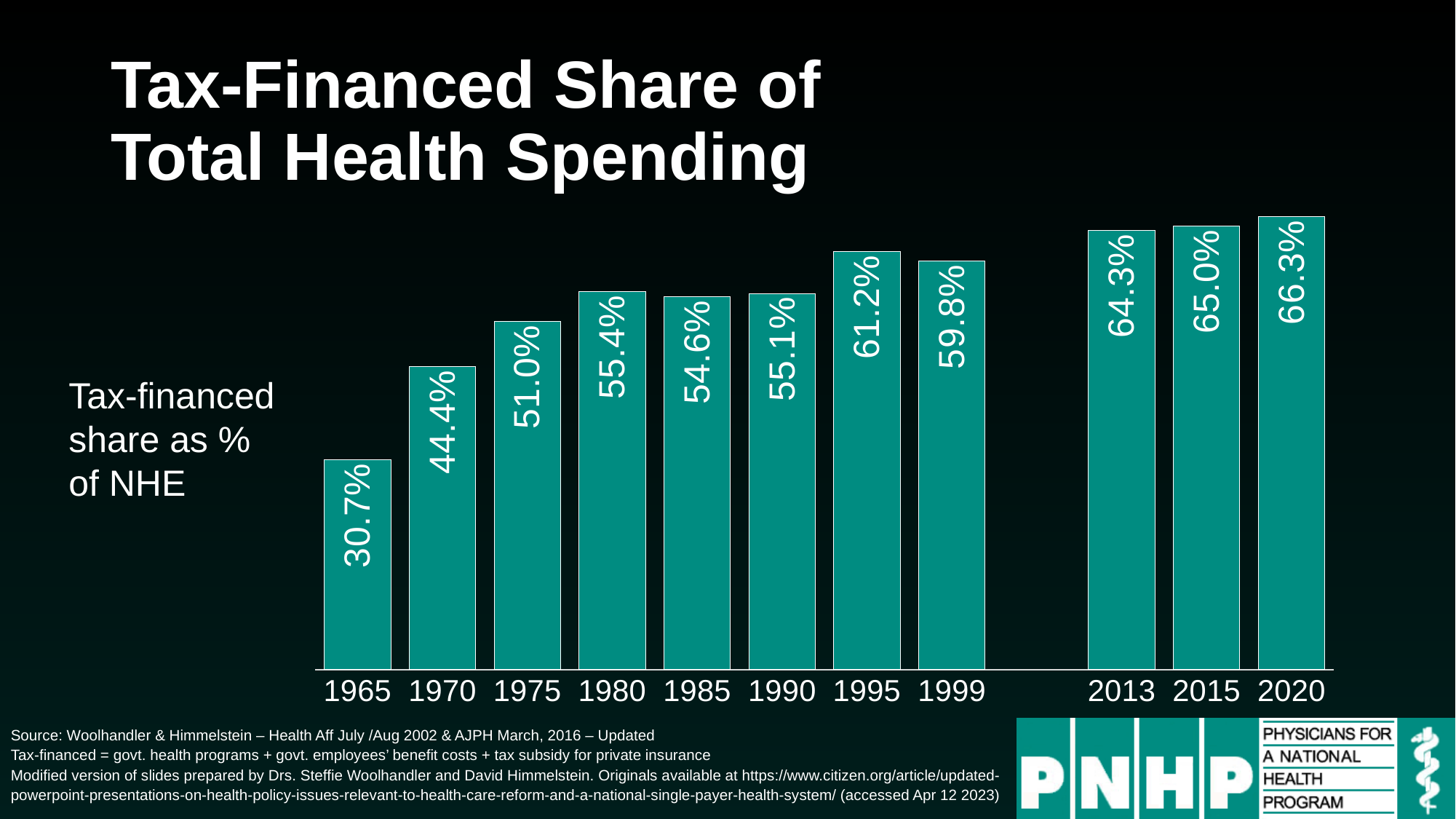
Which year has a larger tax-financed share, 1999 or 2013? 2013 How many years are shown on the chart? 11 What is the difference between the tax-financed share in 1995 and in 1999? 1.4 percentage points Which year has a larger tax-financed share, 1980 or 1985? 1980 What kind of chart is shown on the slide? Bar chart Which year has the highest tax-financed share of total health spending? 2020 What is the tax-financed share of total health spending in 2020? 66.3% Overall, does the tax-financed share rise or fall from 1965 to 2020? Rise What is the difference between the tax-financed share in 2020 and in 1965? 35.6 percentage points What is the tax-financed share of total health spending in 1965? 30.7% What is the tax-financed share of total health spending in 1995? 61.2% Which year has the lowest tax-financed share of total health spending? 1965